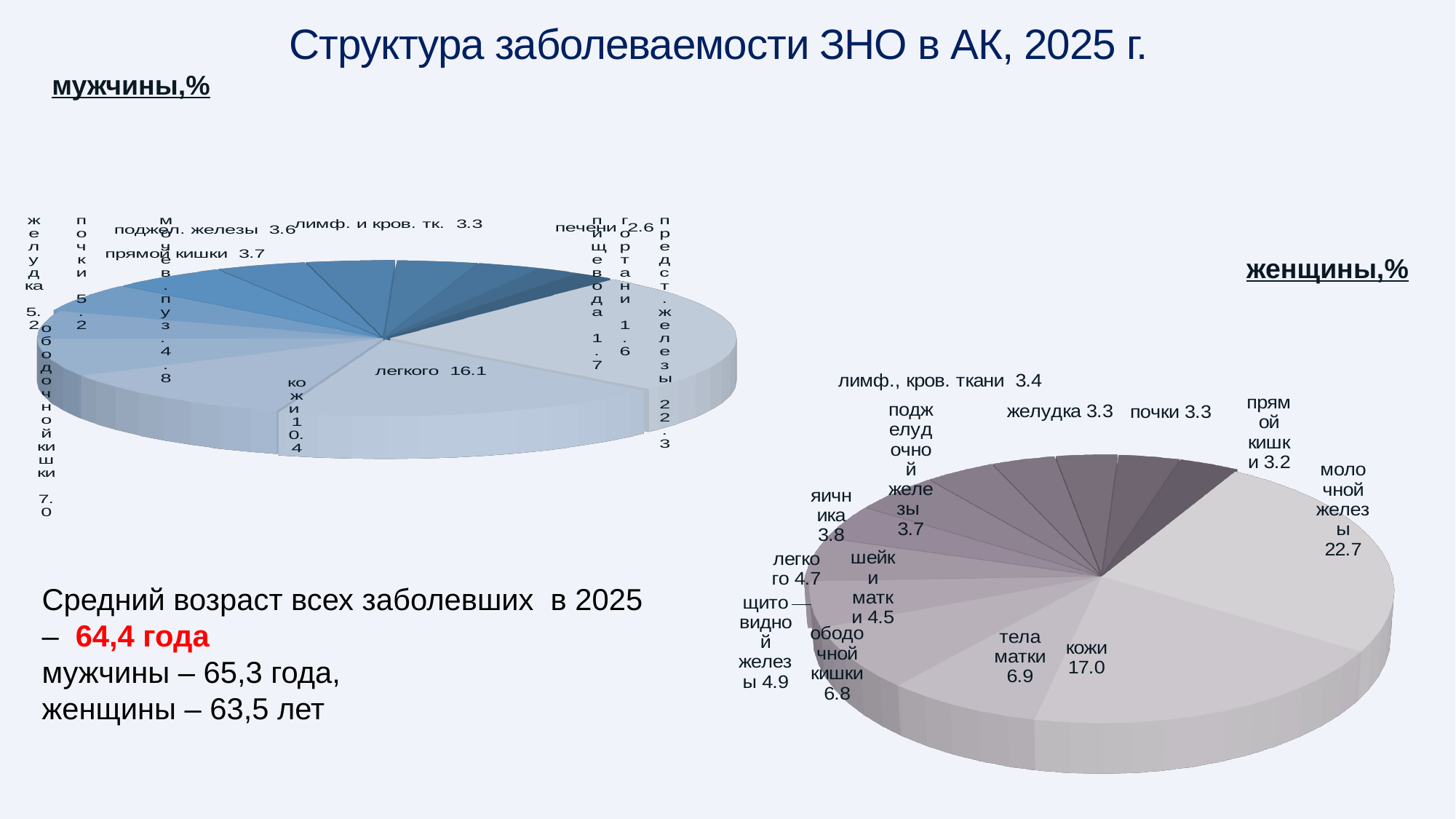
On the men's chart (мужчины,%), what is the difference between the values for легкого and кожи? 5.7 On the women's chart (женщины,%), what is the value for молочной железы? 22.7 On the women's chart (женщины,%), what is the value for кожи? 17.0 What type of chart is used for the men's data (мужчины,%)? pie chart On the women's chart (женщины,%), which category has the largest share? молочной железы On the men's chart (мужчины,%), what is the value for предст. железы? 22.3 On the men's chart (мужчины,%), which category has the largest share? предст. железы On the men's chart (мужчины,%), what is the value for легкого? 16.1 On the men's chart (мужчины,%), which category has the smallest share? гортани What is the title of the slide containing the two charts? Структура заболеваемости ЗНО в АК, 2025 г. On the women's chart (женщины,%), which is larger, тела матки or ободочной кишки? тела матки On the women's chart (женщины,%), what is the difference between the values for молочной железы and кожи? 5.7